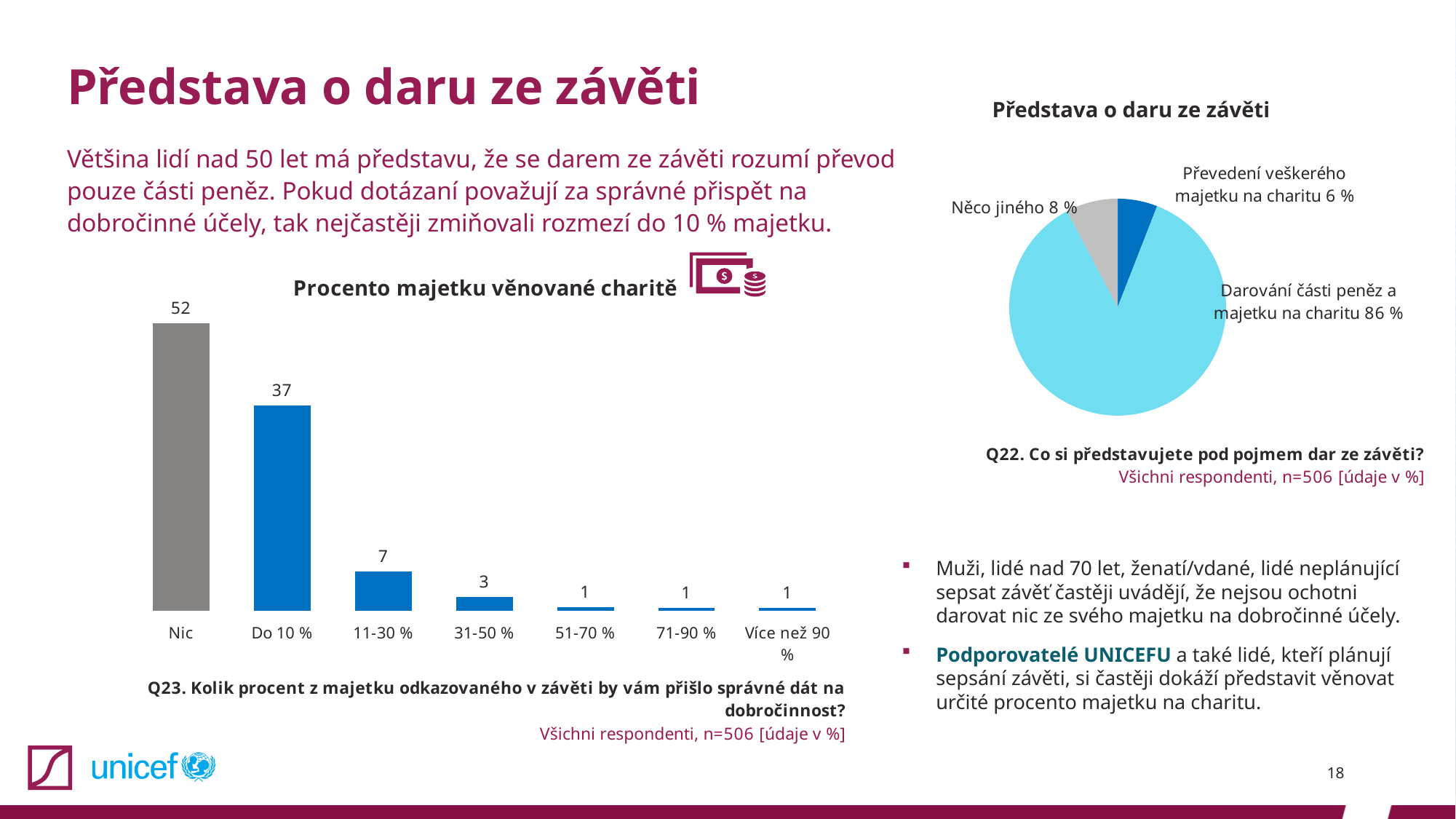
In the pie chart 'Představa o daru ze závěti', what share is 'Převedení veškerého majetku na charitu'? 6 % How many categories are shown in the bar chart 'Procento majetku věnované charitě'? 7 What kind of chart is 'Procento majetku věnované charitě'? bar chart In the pie chart 'Představa o daru ze závěti', which slice is the smallest? Převedení veškerého majetku na charitu In the bar chart 'Procento majetku věnované charitě', do the values rise or fall from left to right? fall In the bar chart 'Procento majetku věnované charitě', what is the value for '11-30 %'? 7 In the bar chart 'Procento majetku věnované charitě', which is larger: the value for '11-30 %' or for '31-50 %'? 11-30 % In the bar chart 'Procento majetku věnované charitě', what is the difference between the values for 'Nic' and 'Do 10 %'? 15 In the bar chart 'Procento majetku věnované charitě', what is the value for 'Do 10 %'? 37 In the pie chart 'Představa o daru ze závěti', what share is 'Darování části peněz a majetku na charitu'? 86 % In the bar chart 'Procento majetku věnované charitě', what is the value for 'Nic'? 52 In the bar chart 'Procento majetku věnované charitě', which category has the highest value? Nic